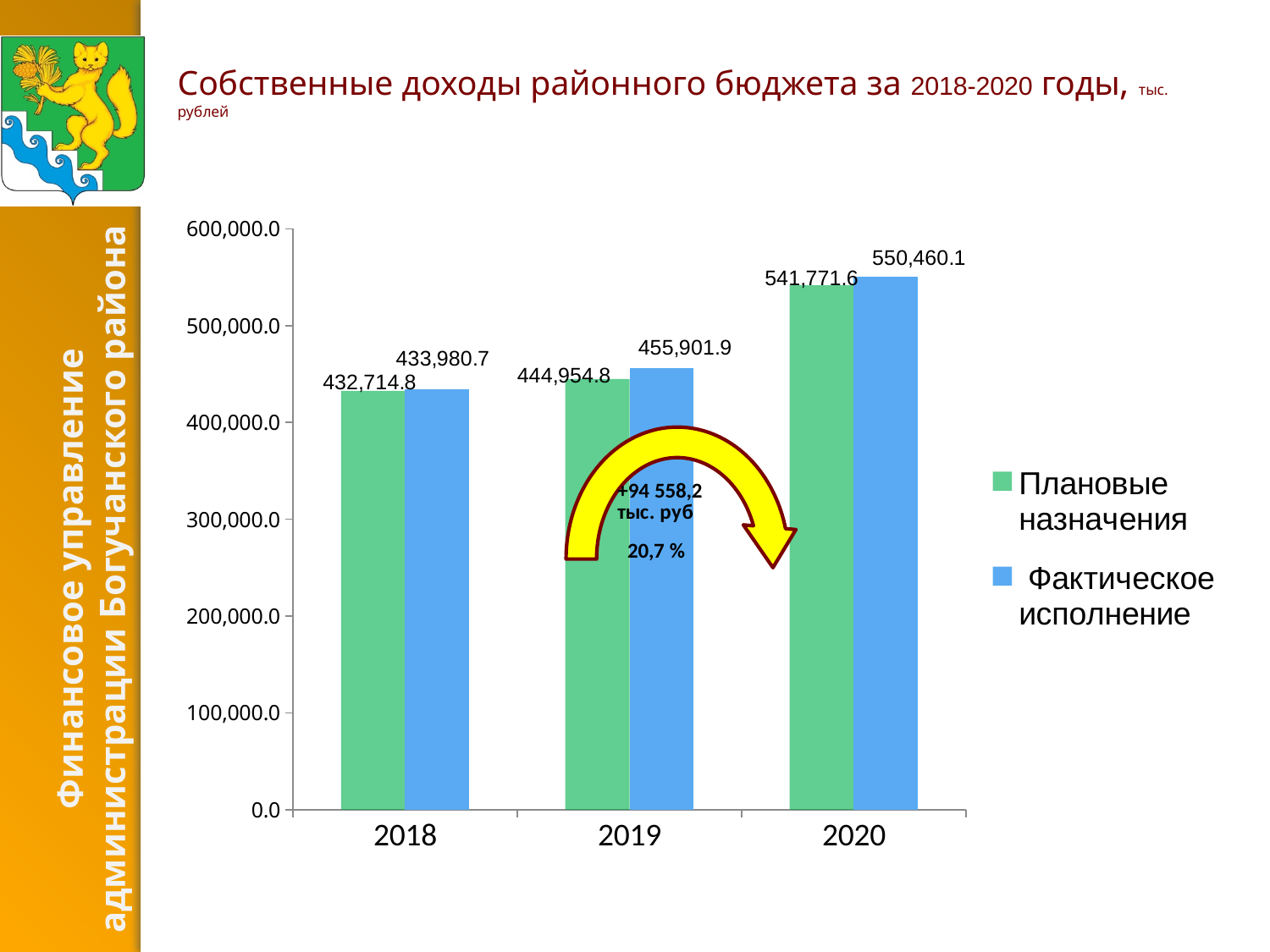
What is the value of Плановые назначения for 2018? 432,714.8 What is the value of Фактическое исполнение for 2020? 550,460.1 What is the difference between Фактическое исполнение and Плановые назначения in 2019? 10,947.1 What kind of chart is shown on the slide? Bar chart How many years are shown on the x axis? 3 What is the difference between Фактическое исполнение in 2020 and in 2019? 94,558.2 How many series does the legend list? 2 Which year has the highest value of Фактическое исполнение? 2020 What is the value of Плановые назначения for 2020? 541,771.6 Which year has the lowest value of Плановые назначения? 2018 What is the value of Фактическое исполнение for 2019? 455,901.9 In 2020, which is larger: Плановые назначения or Фактическое исполнение? Фактическое исполнение